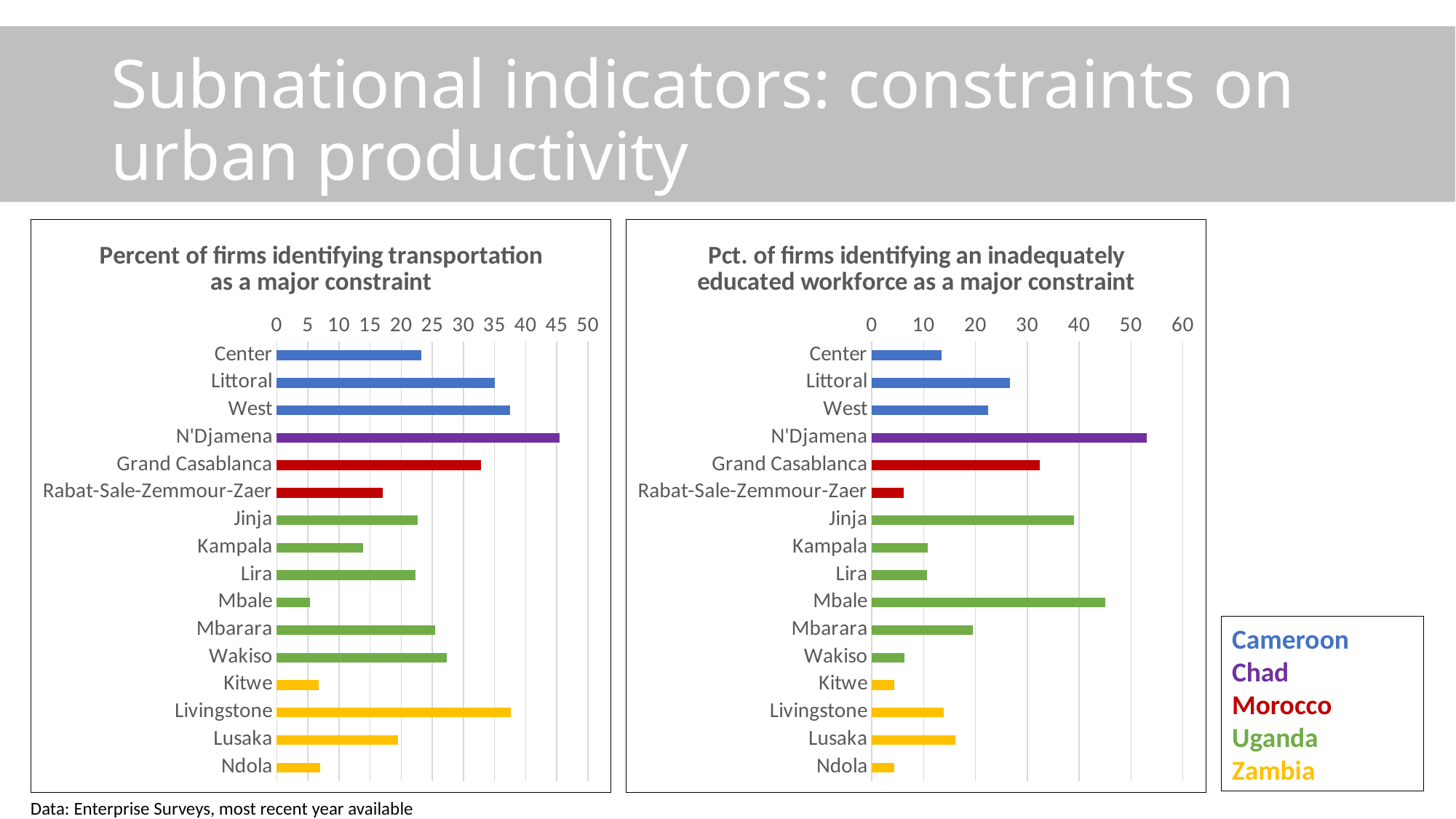
In the left chart on transportation as a major constraint, which has the larger value, Littoral or Kampala? Littoral In the right chart on an inadequately educated workforce, which has the larger value, Grand Casablanca or Rabat-Sale-Zemmour-Zaer? Grand Casablanca In the chart 'Percent of firms identifying transportation as a major constraint', which region has the highest value? N'Djamena In the right chart on an inadequately educated workforce, is the value for Mbale greater or less than 40? greater What type of chart is used for 'Pct. of firms identifying an inadequately educated workforce as a major constraint'? Bar chart In the right chart on an inadequately educated workforce, which has the larger value, Jinja or Kampala? Jinja In the left chart on transportation as a major constraint, is the value for N'Djamena greater or less than 40? greater How many countries does the colour legend on the right of the slide list? 5 In the chart 'Pct. of firms identifying an inadequately educated workforce as a major constraint', which region has the highest value? N'Djamena In the right chart on an inadequately educated workforce, is the value for Rabat-Sale-Zemmour-Zaer greater or less than 10? less How many regions are plotted in the left chart on transportation as a major constraint? 16